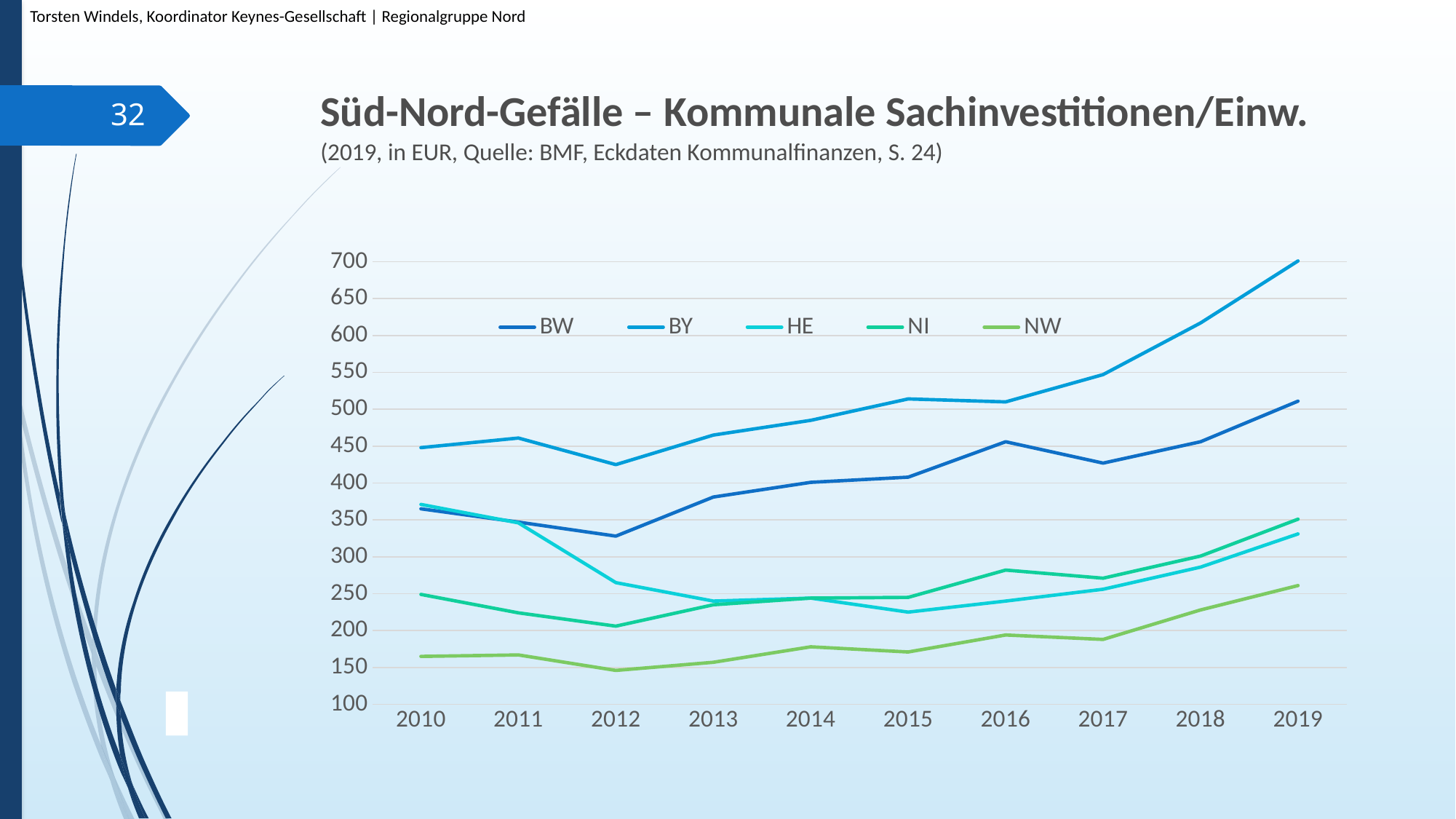
Which series has the lowest value in 2019? NW Is the value for NI in 2012 greater or less than 250? less Is the value for HE in 2010 greater or less than 350? greater Which is larger in 2016, the value for BY or the value for BW? BY What kind of chart is shown on the slide? line chart What is the title of the chart? Süd-Nord-Gefälle – Kommunale Sachinvestitionen/Einw. Which series has the highest value in 2019? BY Is the value for BW in 2019 greater or less than 500? greater Does the value for BY rise or fall between 2015 and 2019? rise How many series does the legend list? 5 How many years are shown on the x axis? 10